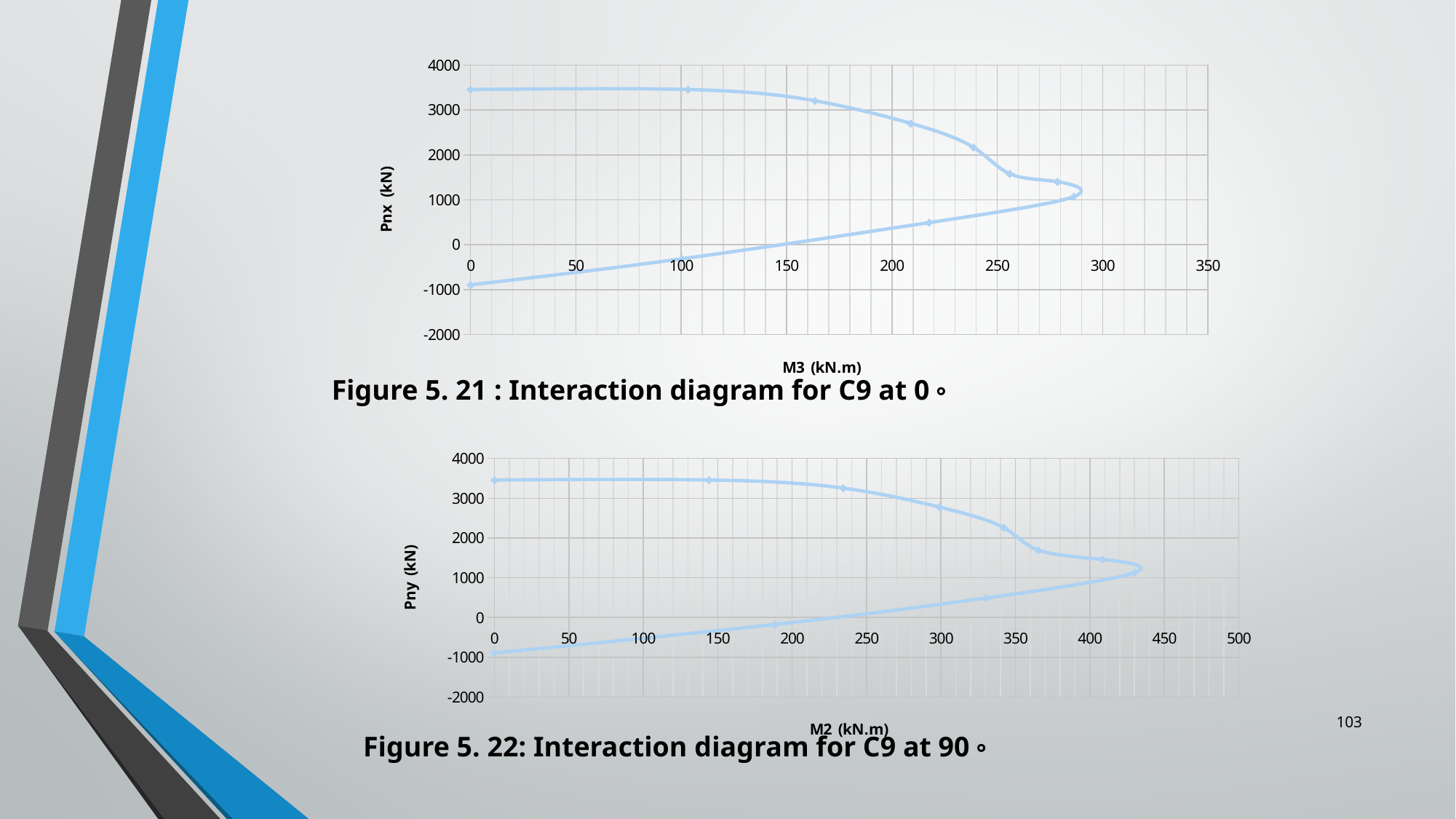
What kind of chart is Figure 5.22 (the bottom chart)? line chart In Figure 5.22 (the bottom chart), is the lowest Pny value on the curve greater or less than 0? less In Figure 5.22 (the bottom chart), what is the title of the horizontal axis? M2 (kN.m) In Figure 5.21 (the top chart), what is the title of the vertical axis? Pnx (kN) In Figure 5.21 (the top chart), is the highest Pnx value on the curve greater or less than 3000? greater In Figure 5.21 (the top chart), is the largest M3 value reached by the curve greater or less than 300? less Which chart's curve reaches a larger maximum moment value, Figure 5.21 (top) or Figure 5.22 (bottom)? Figure 5.22 (bottom) In Figure 5.22 (the bottom chart), what is the largest tick value shown on the horizontal axis? 500 What kind of chart is Figure 5.21 (the top chart)? line chart